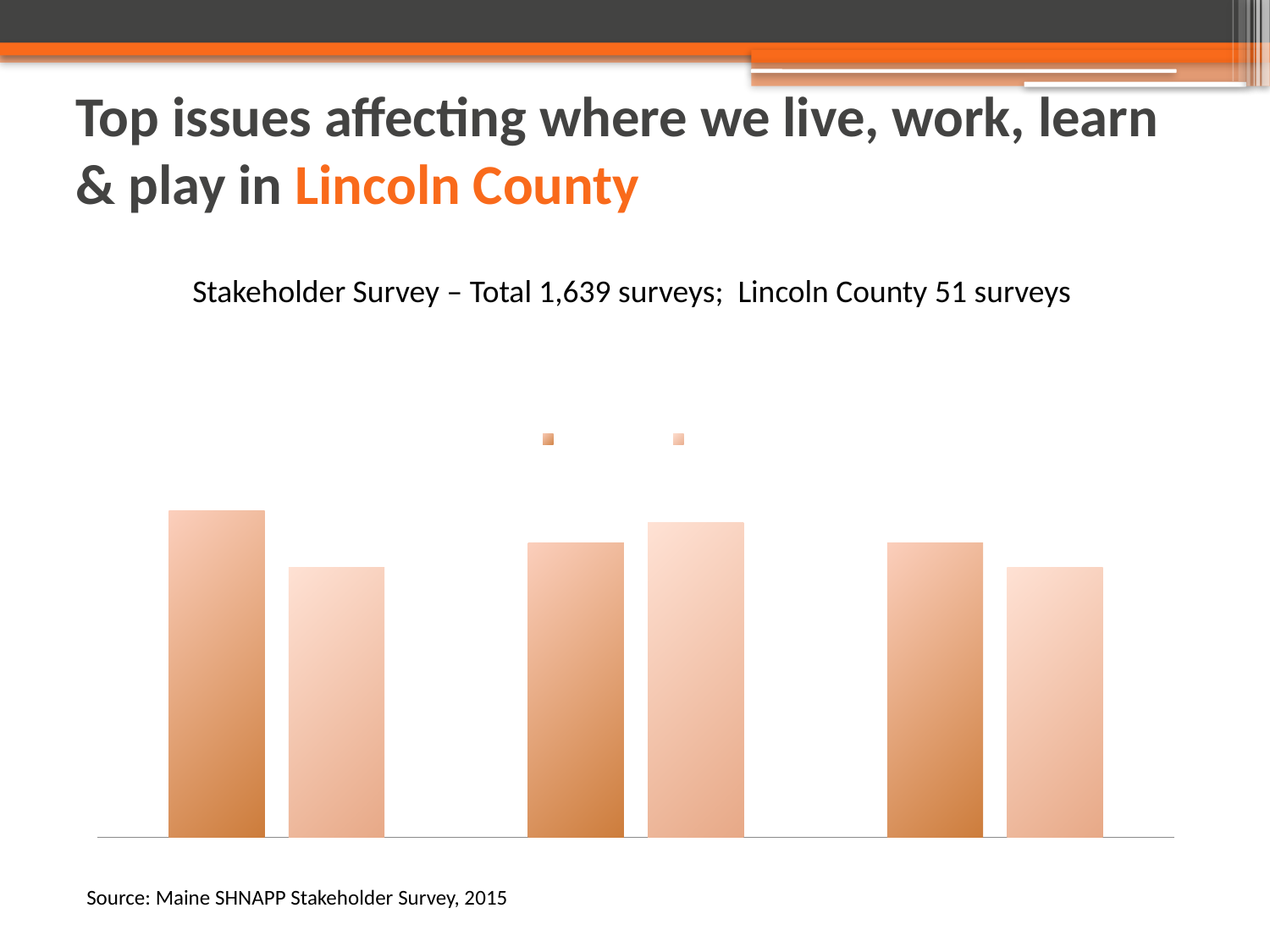
In the leftmost group of bars, is the darker orange bar taller or shorter than the lighter bar? taller How many bars are plotted in total in the chart? 6 What kind of chart is shown on the slide? bar chart In the rightmost group of bars, is the darker orange bar taller or shorter than the lighter bar? taller In the middle group of bars, is the darker orange bar taller or shorter than the lighter bar? shorter How many entries does the chart's legend show? 2 Which group of bars contains the tallest bar in the chart: the leftmost, middle, or rightmost? leftmost What colour are the bars in the chart? orange How many groups of bars are plotted in the chart? 3 Does the chart display any numeric data labels on the bars? No